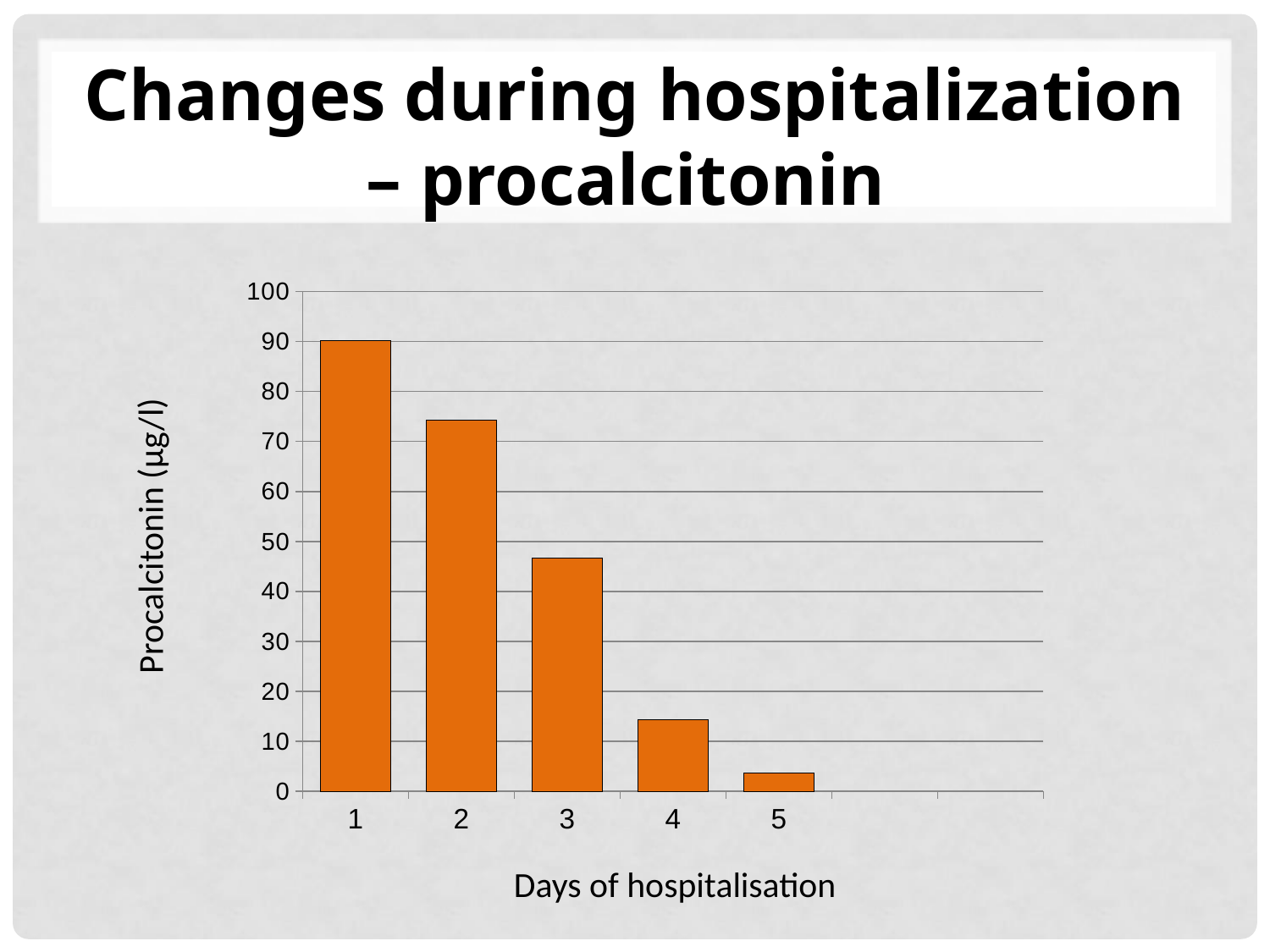
Do the procalcitonin values rise or fall across the days of hospitalisation? fall Which has a lower procalcitonin value, day 4 or day 5? day 5 Which has a higher procalcitonin value, day 2 or day 3? day 2 Is the procalcitonin value for day 4 greater or less than 10? greater Is the procalcitonin value for day 2 greater or less than 70? greater How many days of hospitalisation are plotted on the chart? 5 What is the label of the horizontal axis of the chart? Days of hospitalisation Is the procalcitonin value for day 3 greater or less than 50? less What is the label of the vertical axis of the chart? Procalcitonin (µg/l) Which day of hospitalisation has the highest procalcitonin value? 1 What kind of chart is shown on the slide? bar chart Which day of hospitalisation has the lowest procalcitonin value? 5